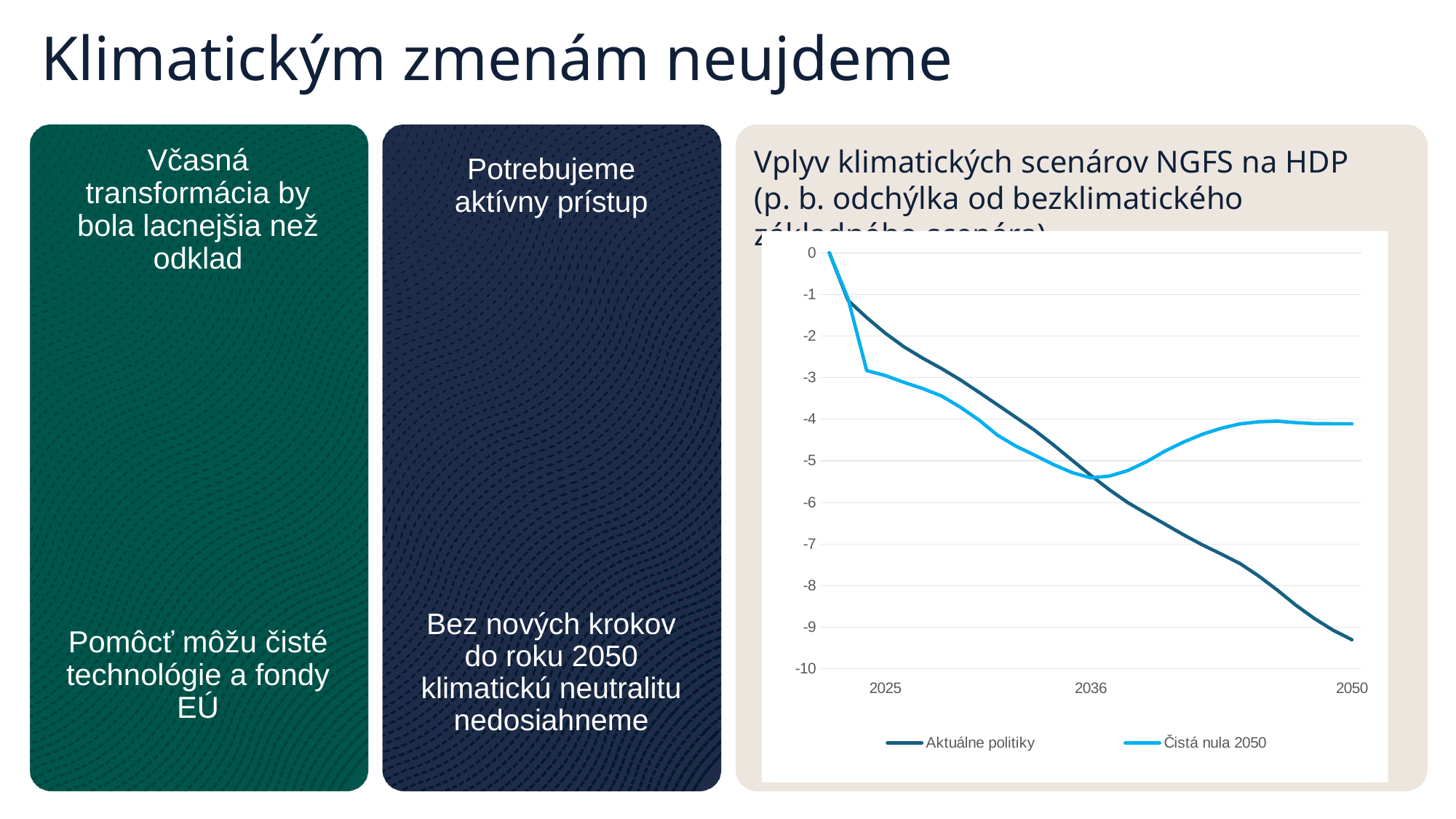
Is the value of Aktuálne politiky in 2050 greater or less than -9? less Which series is drawn in the lighter blue colour? Čistá nula 2050 How many series does the chart legend list? 2 What kind of chart is shown on the slide? line chart How many year labels are shown on the x axis? 3 In 2050, which series has the higher value, Aktuálne politiky or Čistá nula 2050? Čistá nula 2050 Does the Aktuálne politiky line rise or fall from 2025 to 2050? fall Is the value of Čistá nula 2050 in 2050 greater or less than -5? greater What are the two series named in the chart legend? Aktuálne politiky and Čistá nula 2050 Is the value of Aktuálne politiky in 2036 greater or less than -5? less In 2025, which series has the higher value, Aktuálne politiky or Čistá nula 2050? Aktuálne politiky